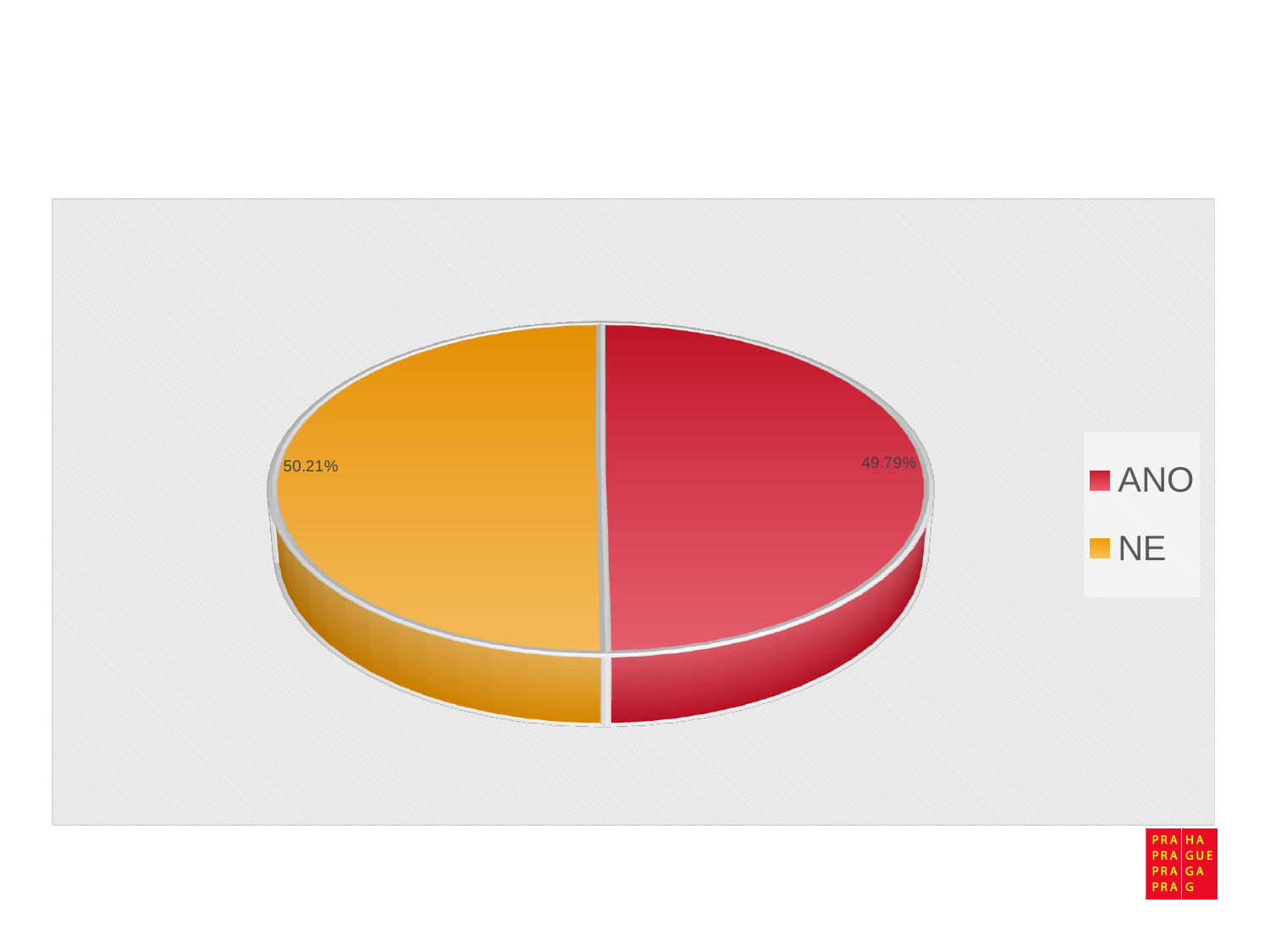
What is the value printed on the red slice of the pie? 49.79% How many slices does the pie chart have? 2 Which category has the largest share of the pie? NE What is the difference between the NE share and the ANO share? 0.42% What colour is the ANO slice in the pie chart? red How many entries does the legend list? 2 What is the value printed on the orange slice of the pie? 50.21% What share of the pie does the ANO slice represent? 49.79% Which slice has the larger share, ANO or NE? NE What share of the pie does the NE slice represent? 50.21% What kind of chart is shown on the slide? pie chart Which category has the smallest share of the pie? ANO